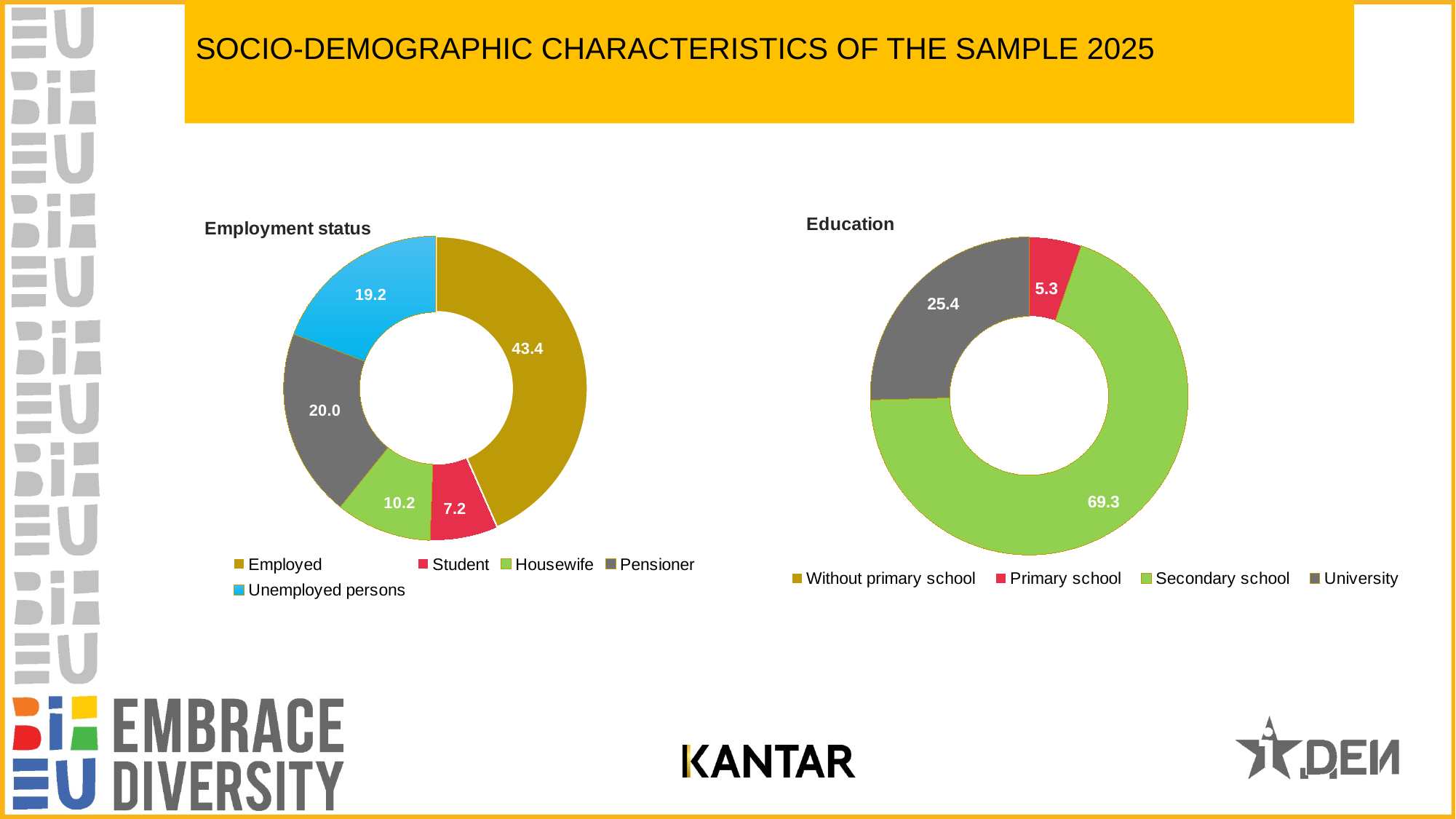
In the Education chart, what is the value for Secondary school? 69.3 In the Employment status chart, how many categories does the legend list? 5 In the Employment status chart, what is the value for Unemployed persons? 19.2 In the Employment status chart, what is the value for Employed? 43.4 In the Education chart, which is larger, University or Primary school? University In the Education chart, what is the value for University? 25.4 What kind of chart is the Education chart? Donut (pie) chart In the Employment status chart, which category has the largest slice? Employed In the Employment status chart, which category has the smallest slice? Student In the Employment status chart, what is the difference between the values for Housewife and Student? 3.0 In the Employment status chart, what is the value for Pensioner? 20.0 In the Education chart, what is the value for Primary school? 5.3